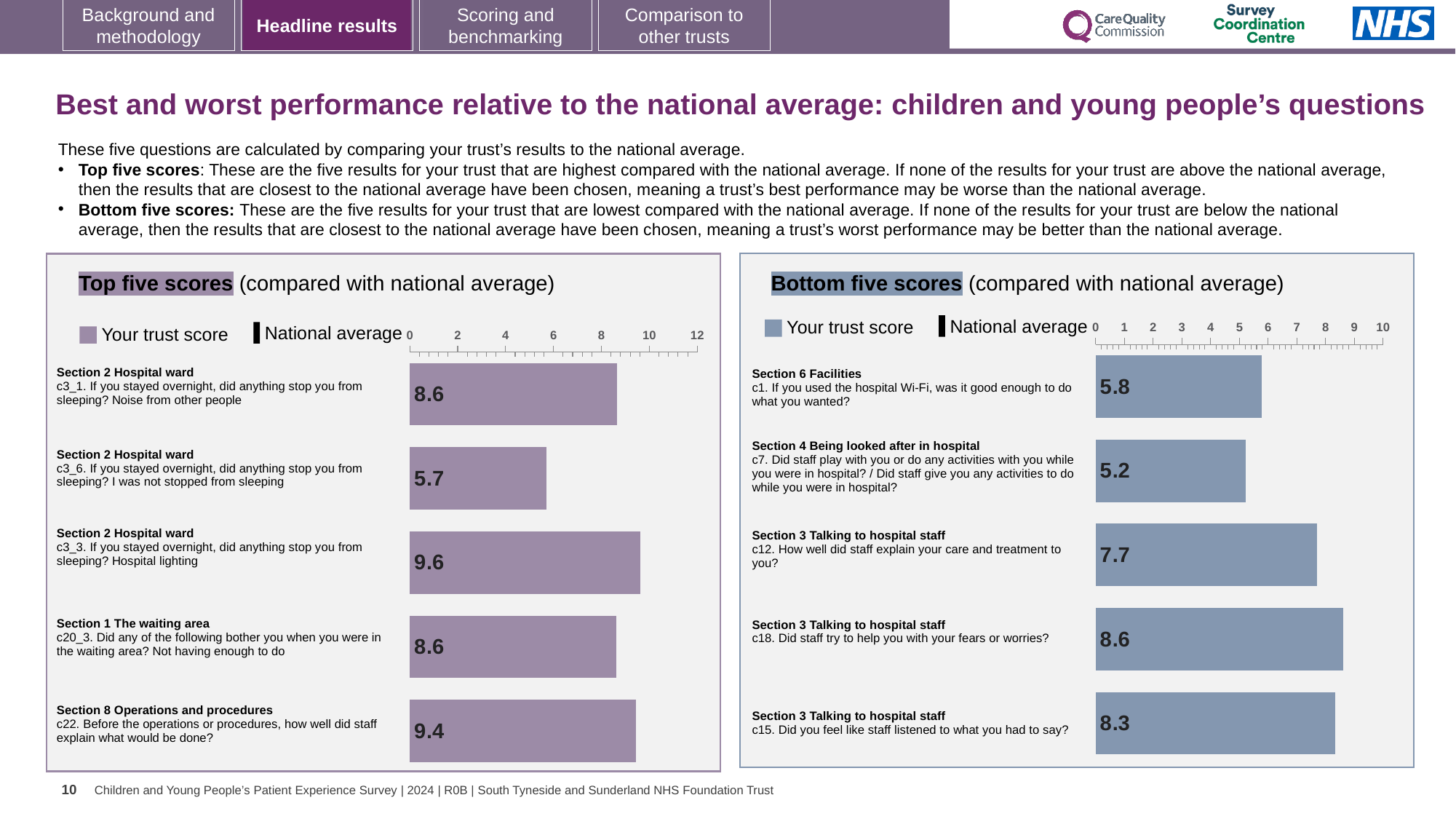
How many series does the legend of the Bottom five scores chart list? 2 In the Top five scores chart, which question has the lowest trust score? c3_6. I was not stopped from sleeping In the Top five scores chart, how many questions are plotted? 5 In the Top five scores chart, what is the trust score for c22 (how well did staff explain what would be done)? 9.4 In the Bottom five scores chart, which question has the highest trust score? c18. Did staff try to help you with your fears or worries? What type of chart is used in the Top five scores panel? Bar chart In the Top five scores chart, what is the difference between the scores for c3_3 and c3_6? 3.9 In the Bottom five scores chart, which question has the lowest trust score? c7. Did staff play with you or do any activities with you In the Bottom five scores chart, is the score for c12 larger or smaller than the score for c15? smaller In the Top five scores chart, what is the trust score for c3_3 (Hospital lighting)? 9.6 In the Bottom five scores chart, what is the trust score for c1 (hospital Wi-Fi)? 5.8 In the Bottom five scores chart, what is the difference between the scores for c18 and c7? 3.4